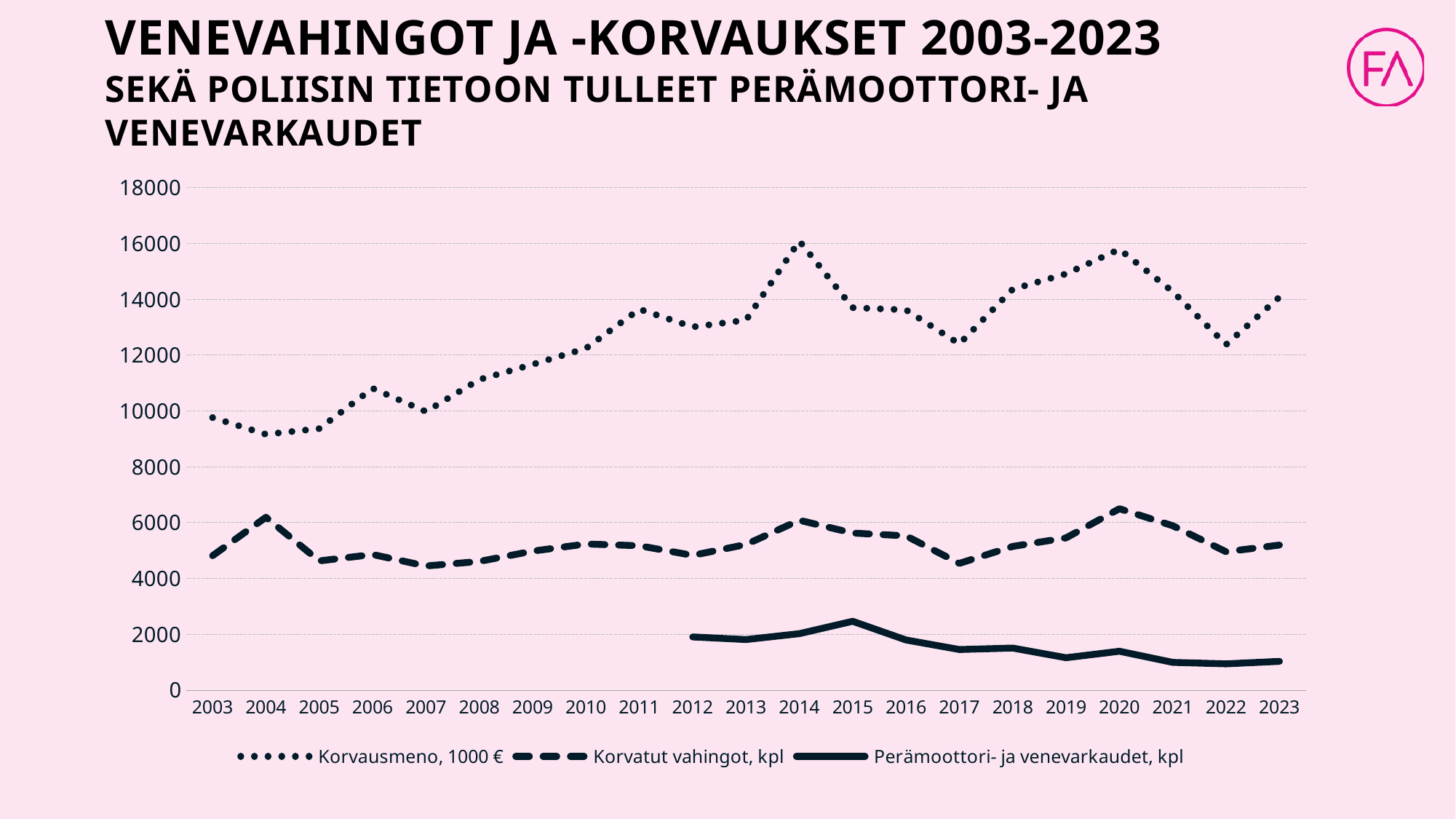
In which year does the Korvausmeno, 1000 € series reach its highest value? 2014 Is the value for Perämoottori- ja venevarkaudet, kpl in 2023 greater or less than 2000? less In which year does the Perämoottori- ja venevarkaudet, kpl series first have a plotted value? 2012 In which year does the Korvatut vahingot, kpl series reach its highest value? 2020 How many years are shown on the x axis? 21 Is the value for Korvausmeno, 1000 € in 2014 greater or less than 14000? greater How many series does the legend list? 3 Which year has the higher value for Korvausmeno, 1000 €: 2022 or 2023? 2023 Is the value for Korvatut vahingot, kpl in 2017 greater or less than 6000? less Does the Perämoottori- ja venevarkaudet, kpl series rise or fall from 2015 to 2023? Fall In which year does the Perämoottori- ja venevarkaudet, kpl series reach its highest value? 2015 What kind of chart is shown on the slide? Line chart